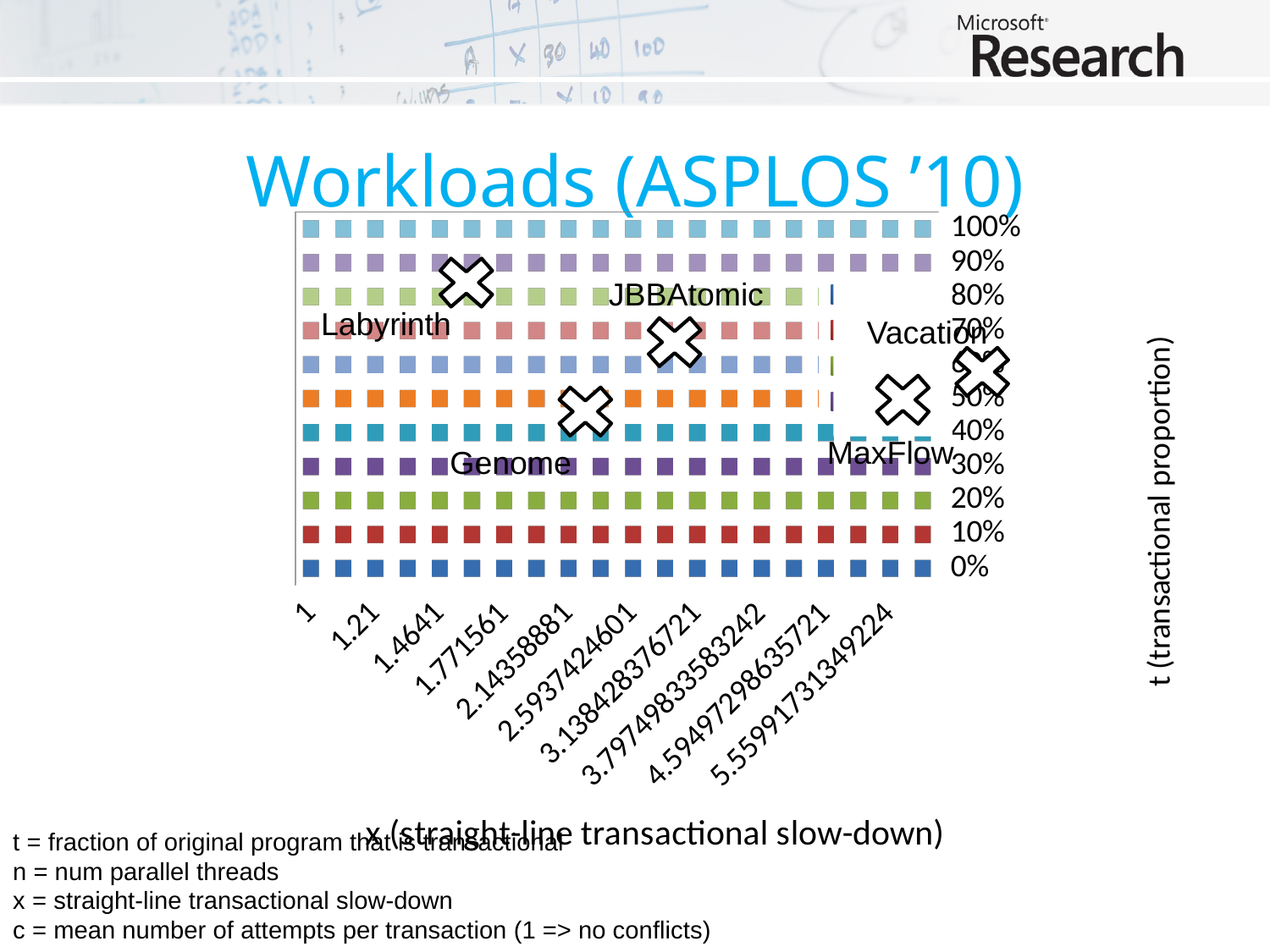
What is the highest tick value on the y axis? 100% What is the label of the x axis? x (straight-line transactional slow-down) What is the title of the chart? Workloads (ASPLOS '10) What is the first tick value on the x axis? 1 Which workload marker has the larger x value, Labyrinth or Vacation? Vacation How many workload names are labelled on the chart? 5 Which workload marker has the higher t value, Labyrinth or Genome? Labyrinth Is the x value for the Labyrinth marker greater or less than 2.14358881? less Is the t value for the Labyrinth marker greater or less than 50%? greater How many tick labels are shown on the y axis (t)? 11 What kind of chart is shown on the slide? surface chart How many tick labels are shown on the x axis? 10